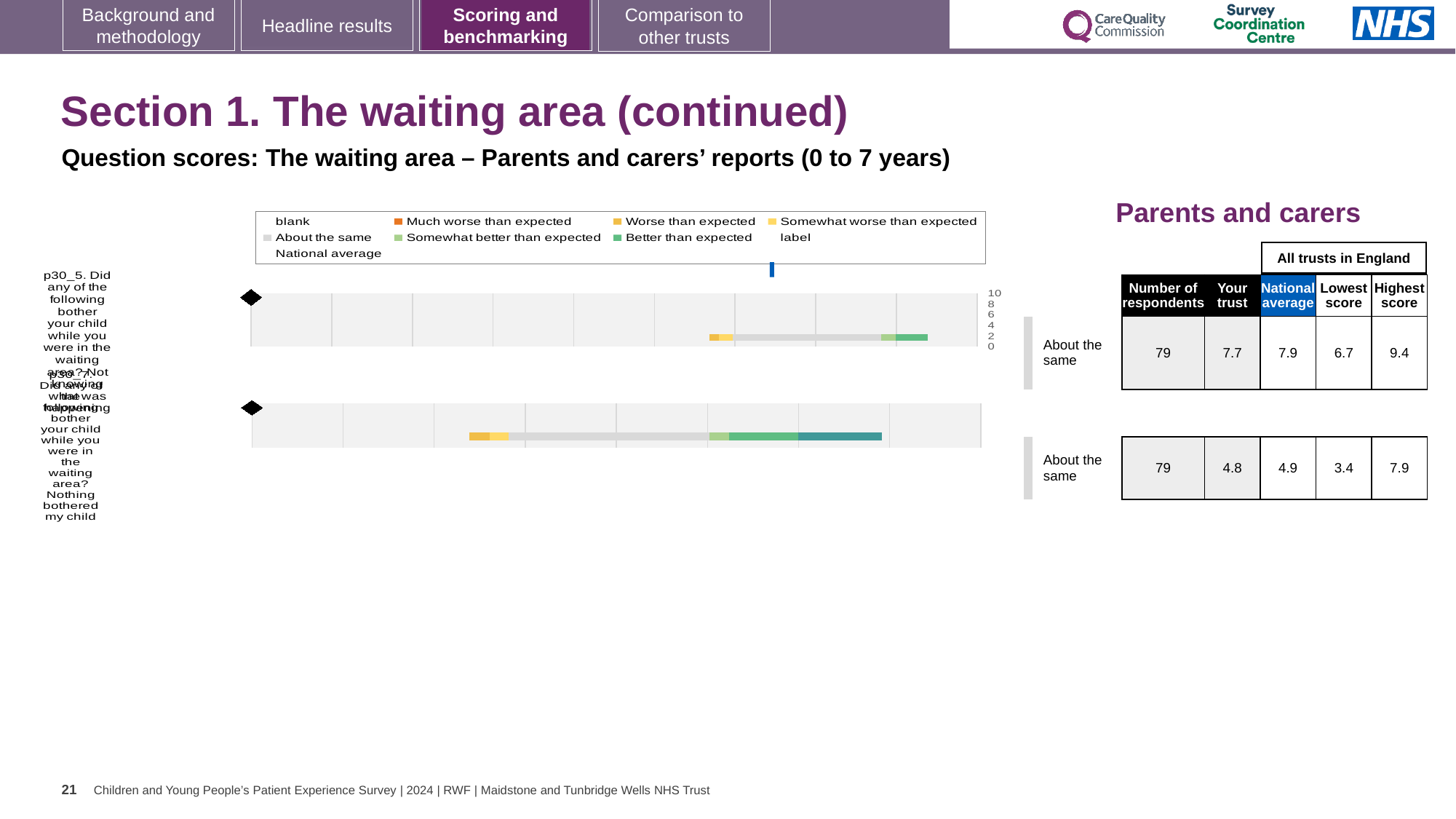
What is the heading above the table to the right of the chart? Parents and carers Which question row has the higher 'Your trust' score, p30_5 or p30_7? p30_5 How many respondents are shown for each question row in the table beside the chart? 79 How many entries does the chart legend list? 9 In the table beside the chart, what is the national average for the second question row (p30_7, nothing bothered my child)? 4.9 What is the difference between the highest score (7.9) and the lowest score (3.4) for the second question row? 4.5 Is the 'Your trust' score for the second question row (4.8) greater or less than 6? less What is the difference between the highest score (9.4) and the lowest score (6.7) for the first question row? 2.7 How many question rows are plotted in the chart area? 2 What benchmark category label is shown next to both question rows? About the same What kind of chart is used to show the question scores on this slide? bar chart In the table beside the chart, what is the 'Your trust' score for the first question row (p30_5, not knowing what was happening)? 7.7